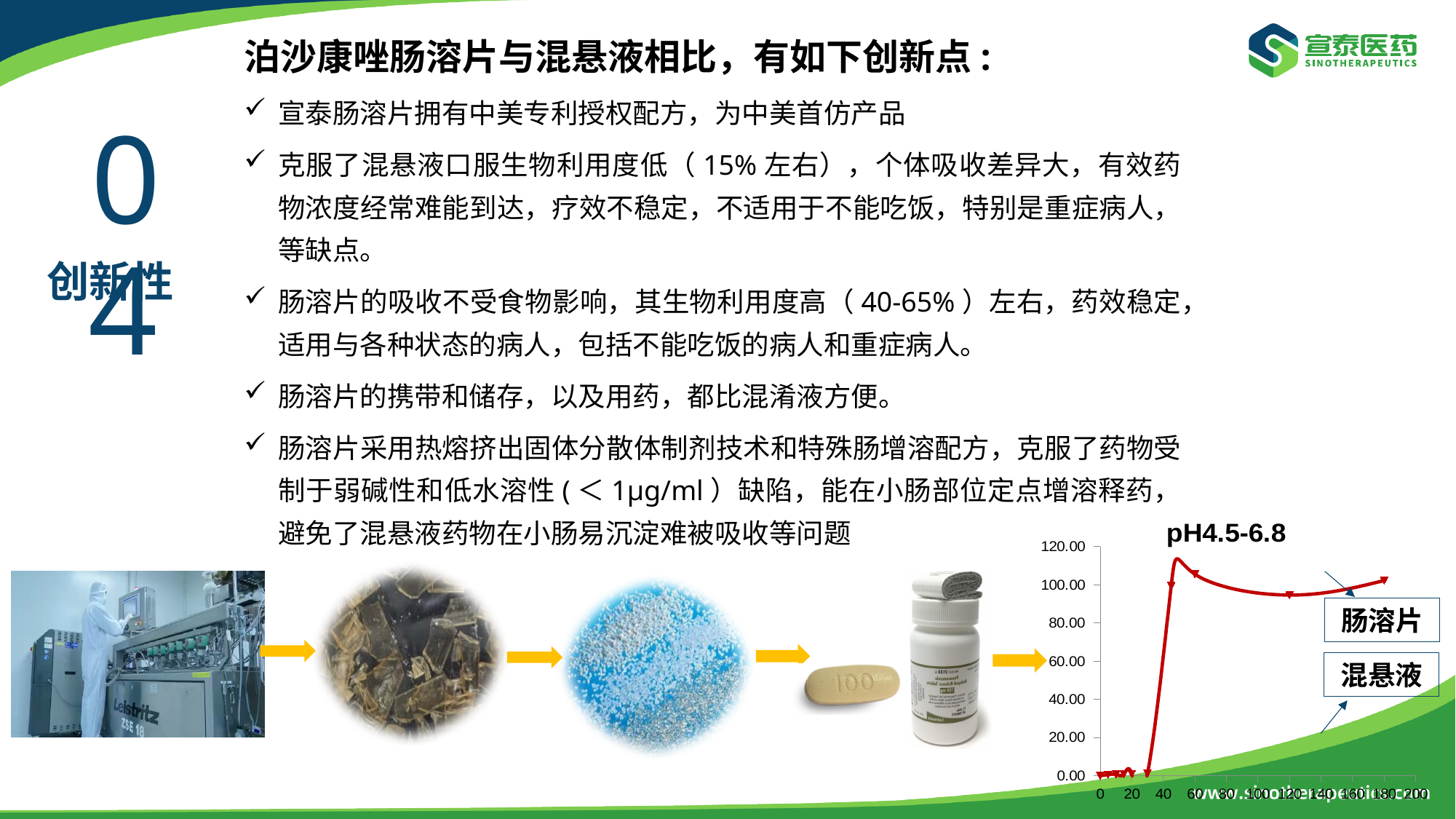
In the chart at the bottom right, is the value of the red line at x = 60 greater or less than 80.00? greater What kind of chart is shown at the bottom right of the slide? line chart In the chart at the bottom right, does the red line rise or fall between x = 60 and x = 120? fall In the chart at the bottom right, does the red line rise or fall between x = 20 and x = 40? rise In the chart at the bottom right, is the value of the red line at x = 0 greater or less than 20.00? less In the chart at the bottom right, is the value of the red line at x = 20 greater or less than 20.00? less In the chart at the bottom right, what is the largest tick value on the x axis? 200 In the chart at the bottom right, what is the highest value shown on the y axis? 120.00